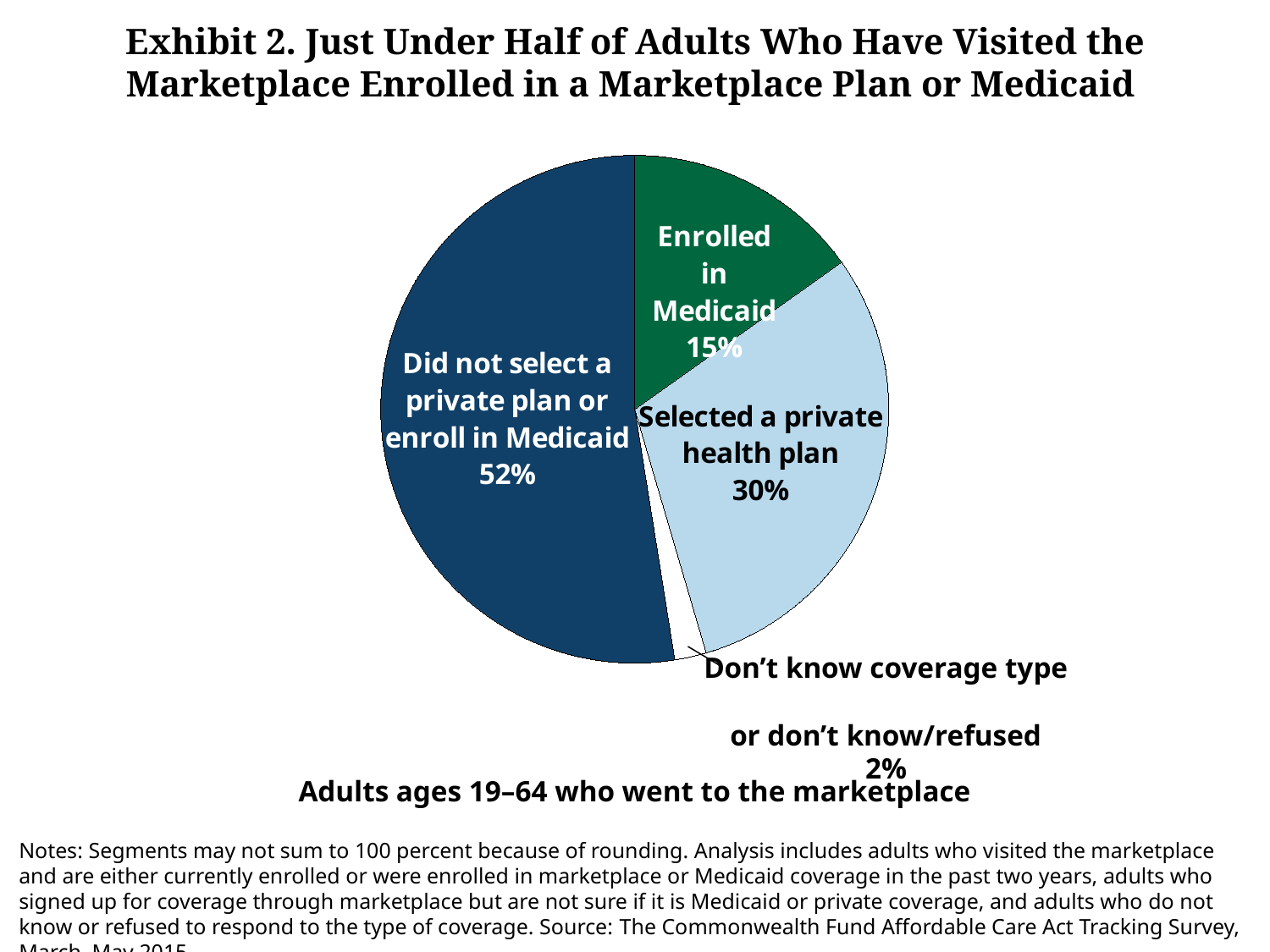
What percentage of adults don't know their coverage type or don't know/refused? 2% Which slice of the pie is the smallest? Don't know coverage type or don't know/refused What is the combined share of adults who selected a private health plan or enrolled in Medicaid? 45% What population does the chart describe, according to the label below the pie? Adults ages 19–64 who went to the marketplace What percentage of adults who went to the marketplace did not select a private plan or enroll in Medicaid? 52% What percentage of adults who went to the marketplace enrolled in Medicaid? 15% Which is larger: the share that selected a private health plan or the share that enrolled in Medicaid? Selected a private health plan How many percentage points larger is the 'Selected a private health plan' slice than the 'Enrolled in Medicaid' slice? 15 How many slices does the pie chart have? 4 Which slice of the pie is the largest? Did not select a private plan or enroll in Medicaid What kind of chart is shown on the slide? Pie chart What percentage of adults who went to the marketplace selected a private health plan? 30%